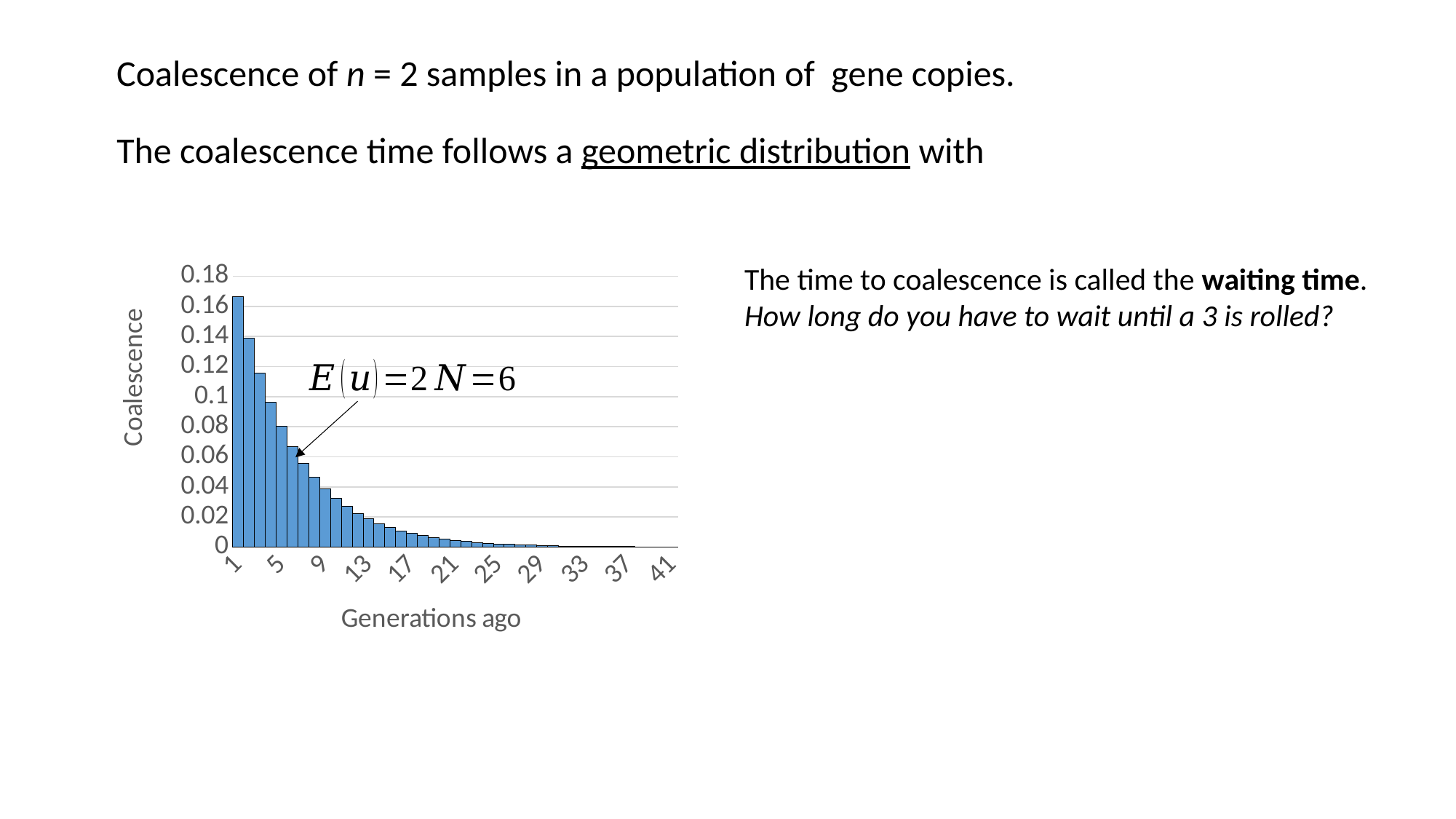
Which has a larger coalescence value, generation 1 or generation 9? generation 1 Is the coalescence value for generation 5 greater or less than 0.1? less Which generation has the highest coalescence value? 1 Is the coalescence value for generation 9 greater or less than 0.06? less What kind of chart is shown on the slide? bar chart What is the label of the x axis? Generations ago Is the coalescence value for generation 13 greater or less than 0.04? less What is the label of the y axis? Coalescence Do the coalescence values rise or fall as generations ago increases? fall Which has a larger coalescence value, generation 5 or generation 21? generation 5